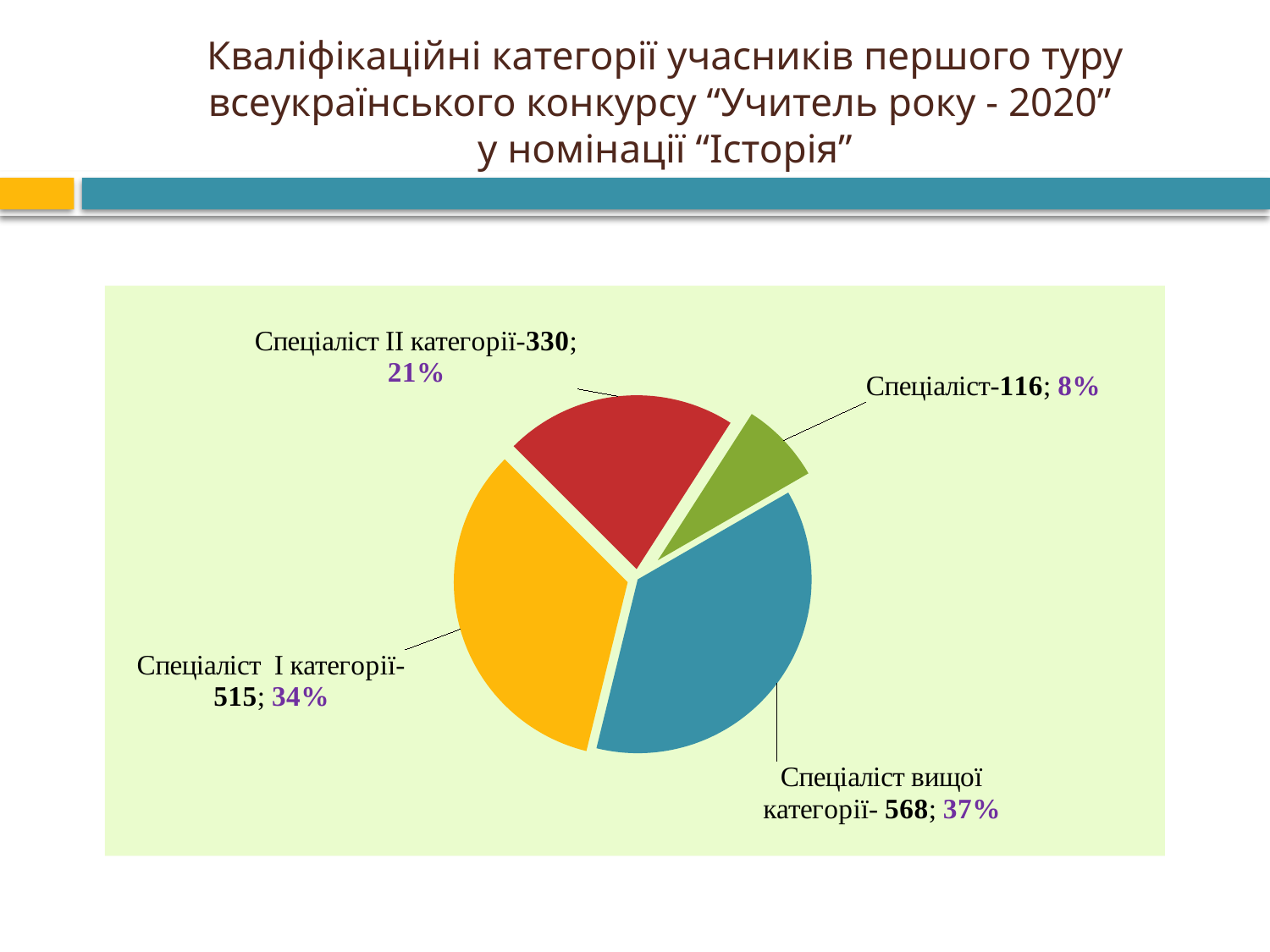
What is the value for Спеціаліст І категорії? 515 What share of the pie does Спеціаліст І категорії represent? 34% What is the value for Спеціаліст? 116 Which category has the smallest slice? Спеціаліст Which is larger, the value for Спеціаліст І категорії or Спеціаліст ІІ категорії? Спеціаліст І категорії Which category has the largest slice? Спеціаліст вищої категорії How many slices does the pie chart have? 4 What kind of chart is shown on the slide? pie chart What is the value for Спеціаліст вищої категорії? 568 What is the value for Спеціаліст ІІ категорії? 330 What is the difference between the values for Спеціаліст вищої категорії and Спеціаліст? 452 What share of the pie does Спеціаліст ІІ категорії represent? 21%